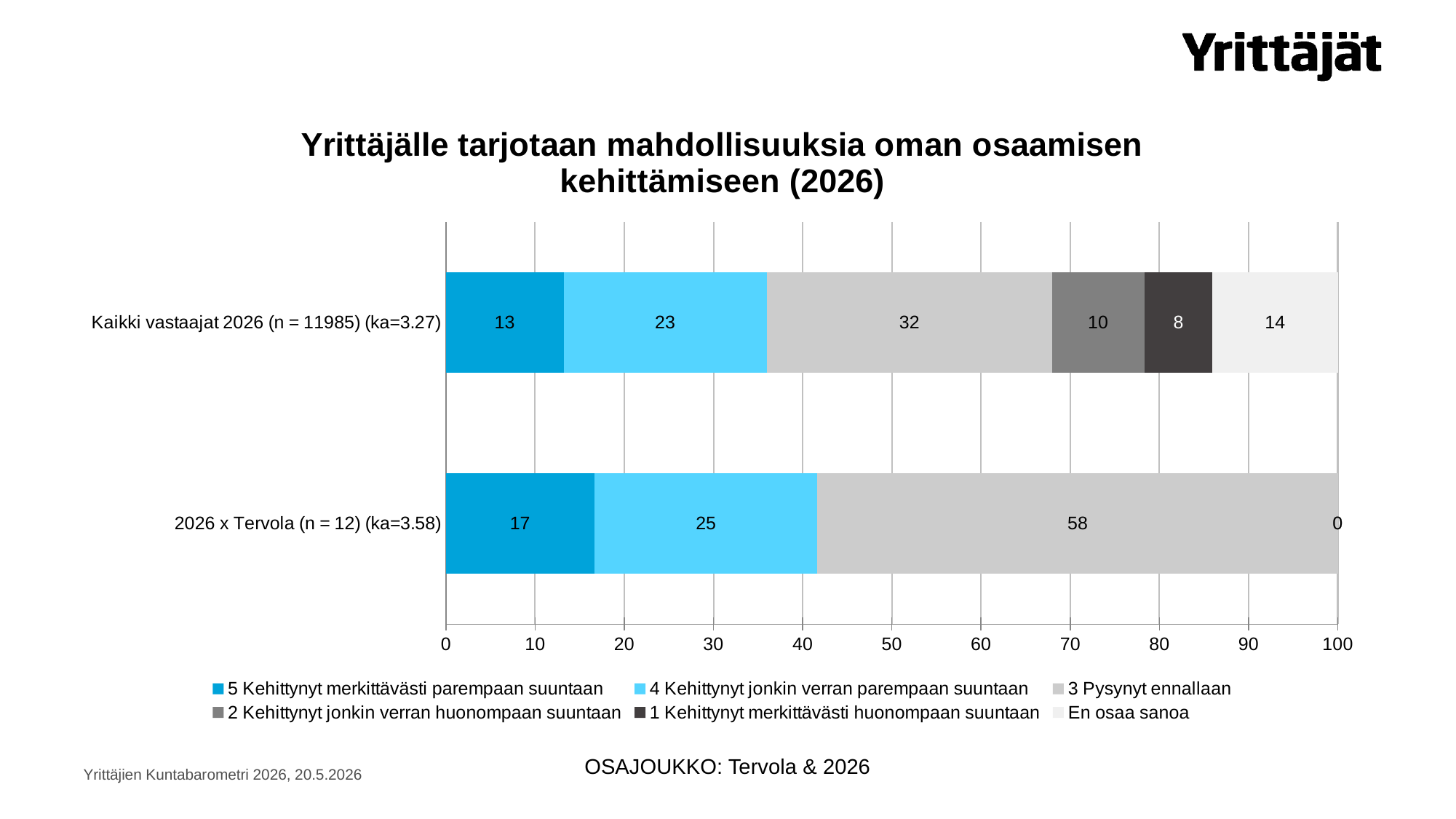
Which series has the smallest value in the 'Kaikki vastaajat 2026 (n = 11985) (ka=3.27)' bar? 1 Kehittynyt merkittävästi huonompaan suuntaan How many series does the legend list? 6 What is the difference between the '3 Pysynyt ennallaan' values for '2026 x Tervola (n = 12) (ka=3.58)' and 'Kaikki vastaajat 2026 (n = 11985) (ka=3.27)'? 26 How many categories (bars) are shown in the chart? 2 Which category has the higher value for '3 Pysynyt ennallaan'? 2026 x Tervola (n = 12) (ka=3.58) What is the value of '4 Kehittynyt jonkin verran parempaan suuntaan' for '2026 x Tervola (n = 12) (ka=3.58)'? 25 What is the title of the chart? Yrittäjälle tarjotaan mahdollisuuksia oman osaamisen kehittämiseen (2026) What is the value of '5 Kehittynyt merkittävästi parempaan suuntaan' for '2026 x Tervola (n = 12) (ka=3.58)'? 17 What type of chart is shown on the slide? stacked bar chart What is the value of 'En osaa sanoa' for 'Kaikki vastaajat 2026 (n = 11985) (ka=3.27)'? 14 Which series has the largest value in the 'Kaikki vastaajat 2026 (n = 11985) (ka=3.27)' bar? 3 Pysynyt ennallaan What is the value of '3 Pysynyt ennallaan' for 'Kaikki vastaajat 2026 (n = 11985) (ka=3.27)'? 32